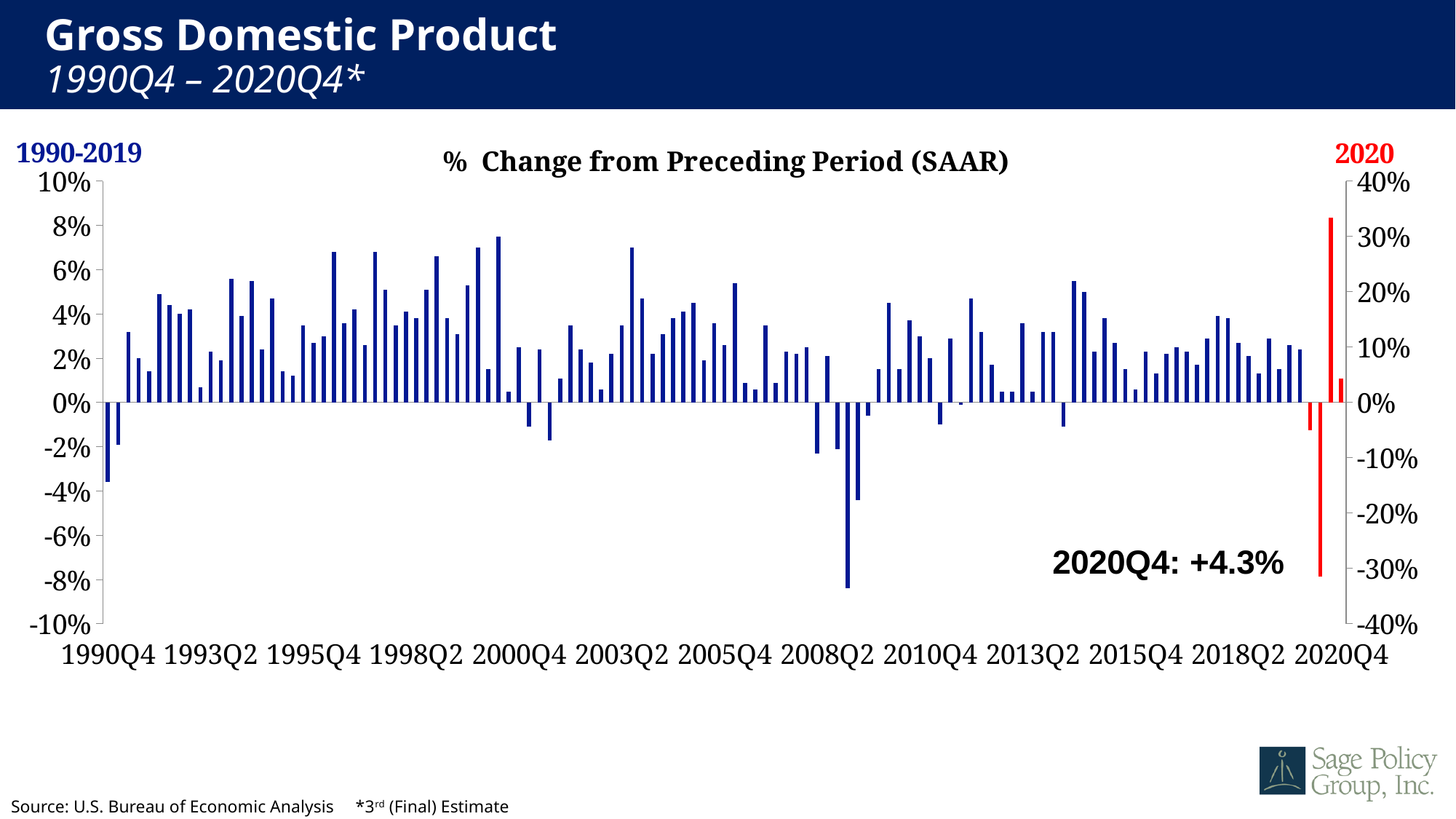
Among the 2020 red bars, which quarter has the lowest value? 2020Q2 Which is larger, the value for 2020Q3 or the value for 2020Q4? 2020Q3 What is the title of the chart? % Change from Preceding Period (SAAR) Is the value for 1990Q4 greater or less than 0%? less Which is larger, the value for 2020Q1 or the value for 2020Q2? 2020Q1 What is the GDP % change for 2020Q4? +4.3% Is the value for 2020Q1 greater or less than 0%? less Is the value for 2020Q2 (red bar, right axis) greater or less than -20%? less What kind of chart is shown on the slide? bar chart What colour are the bars for 2020? red How many series does the chart distinguish (1990-2019 and 2020)? 2